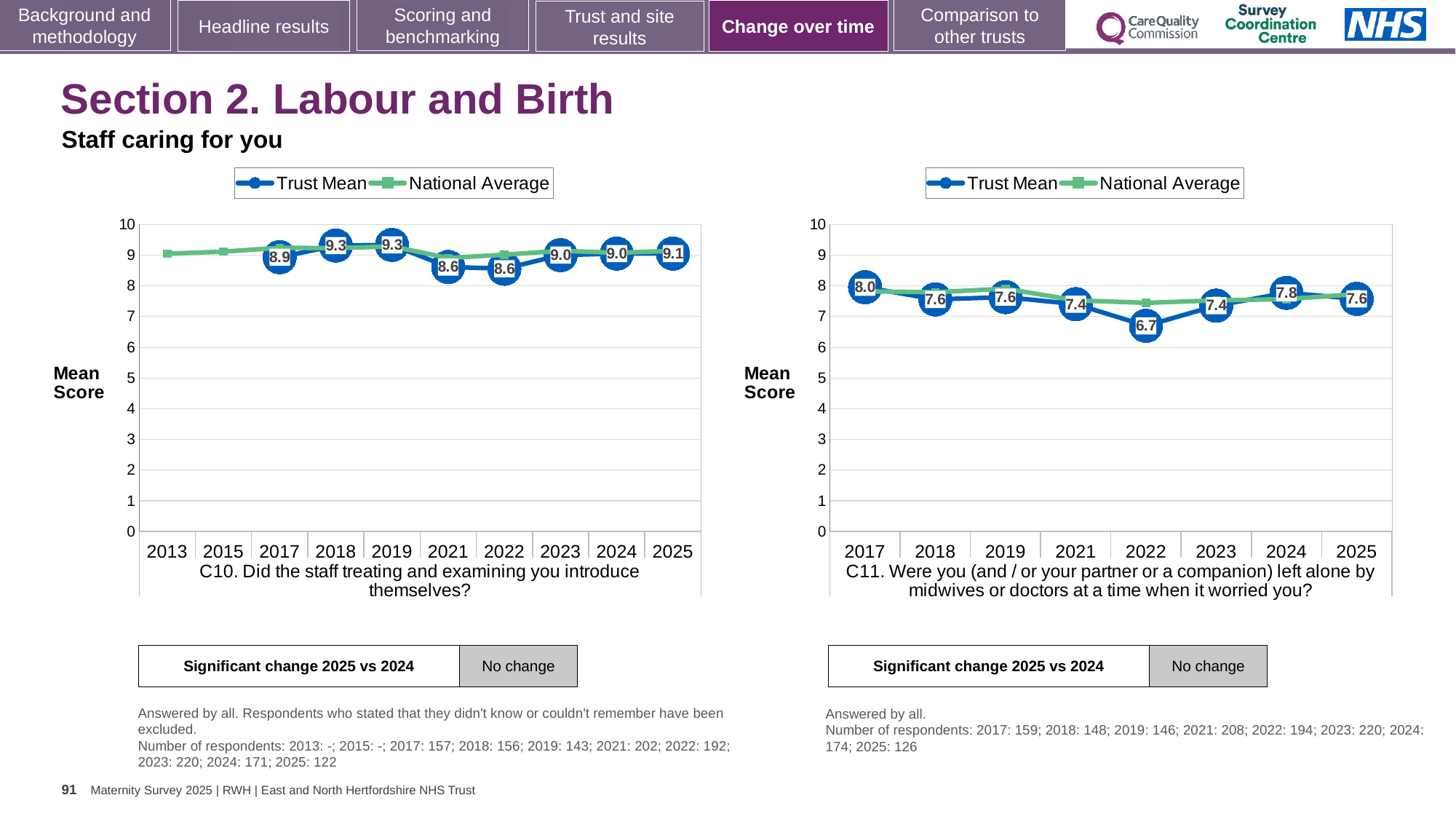
What kind of chart is the C10 chart on the left? Line chart In the C10 chart on the left, what is the Trust Mean score for 2025? 9.1 In the C11 chart on the right, which year has the lowest Trust Mean score? 2022 In the C11 chart on the right, did the Trust Mean score rise or fall from 2017 to 2018? Fall How many series does the legend of the C11 chart on the right list? 2 In the C10 chart on the left, is the Trust Mean score higher in 2018 or in 2017? 2018 In the C11 chart on the right, which year has the highest Trust Mean score? 2017 In the C11 chart on the right, is the National Average value for 2022 greater or less than 7? greater How many years are shown on the x axis of the C10 chart on the left? 10 In the C11 chart on the right, what is the difference between the Trust Mean scores for 2024 and 2022? 1.1 In the C11 chart on the right, what is the Trust Mean score for 2022? 6.7 In the C10 chart on the left, what is the difference between the Trust Mean scores for 2019 and 2021? 0.7